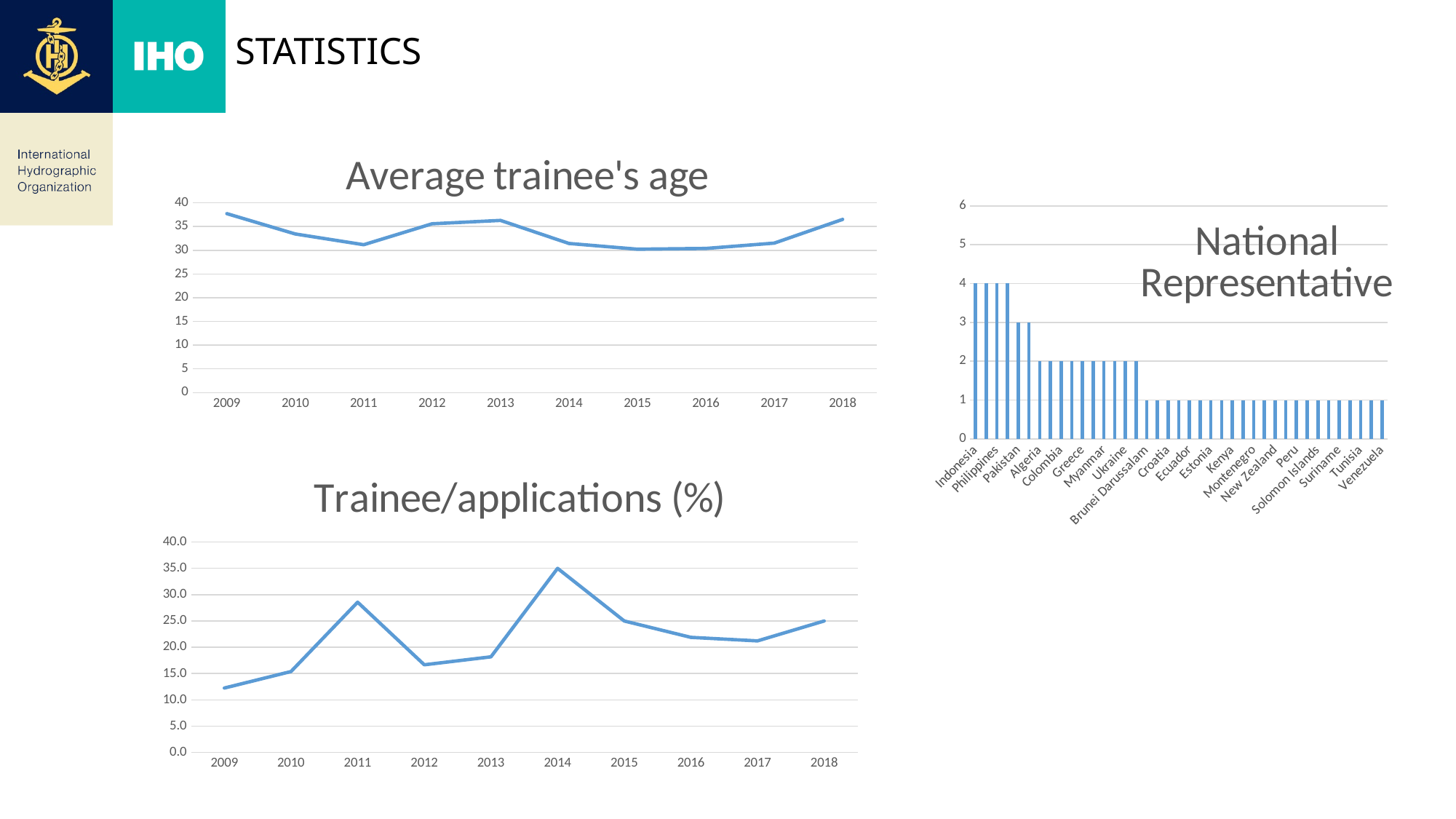
In the 'Average trainee's age' chart, is the value for 2011 greater or less than 35? less In the 'National Representative' chart, what is the value for Indonesia? 4 In the 'Trainee/applications (%)' chart, does the line rise or fall from 2009 to 2011? rise In the 'Average trainee's age' chart, does the line rise or fall from 2013 to 2015? fall What kind of chart is the 'Average trainee's age' chart? line chart In the 'Average trainee's age' chart, is the value for 2009 greater or less than 35? greater In the 'Average trainee's age' chart, how many years are plotted along the x axis? 10 In the 'Trainee/applications (%)' chart, which year has the lowest value? 2009 In the 'Trainee/applications (%)' chart, which year has the highest value? 2014 In the 'Trainee/applications (%)' chart, is the value for 2009 greater or less than 15.0? less In the 'National Representative' chart, what is the value for Venezuela? 1 What kind of chart is the 'National Representative' chart? bar chart